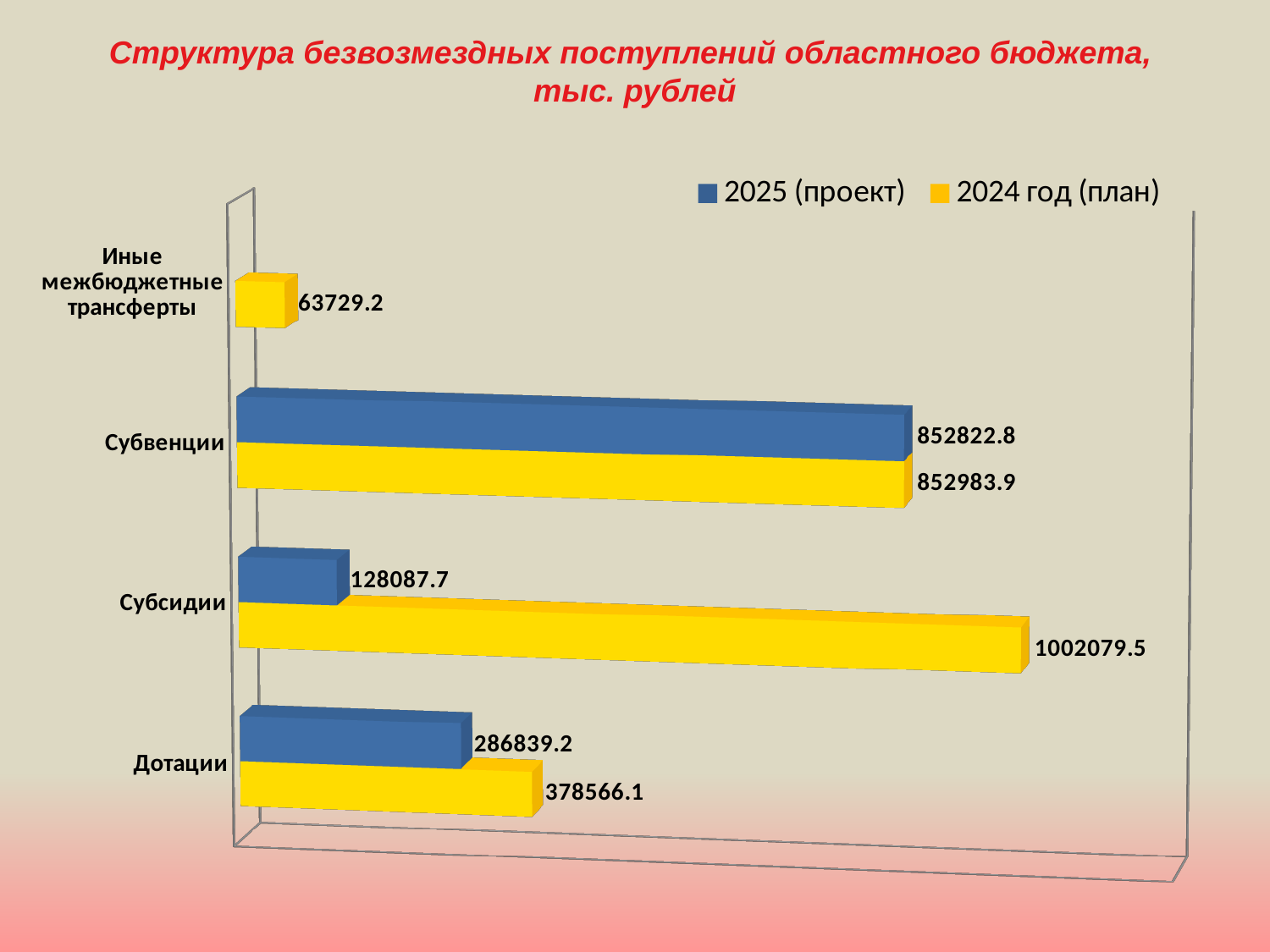
For Дотации, which is larger: the 2024 год (план) value or the 2025 (проект) value? 2024 год (план) What is the value for Субвенции in the 2025 (проект) series? 852822.8 What is the value for Субсидии in the 2024 год (план) series? 1002079.5 What is the value for Дотации in the 2025 (проект) series? 286839.2 What is the difference between the 2024 год (план) and 2025 (проект) values for Дотации? 91726.9 What is the difference between the 2024 год (план) and 2025 (проект) values for Субсидии? 873991.8 Which category has the lowest value in the 2024 год (план) series? Иные межбюджетные трансферты What is the value for Иные межбюджетные трансферты in the 2024 год (план) series? 63729.2 Which category has the highest value in the 2025 (проект) series? Субвенции How many series does the legend list? 2 What kind of chart is shown on the slide? Bar chart Which category has the highest value in the 2024 год (план) series? Субсидии